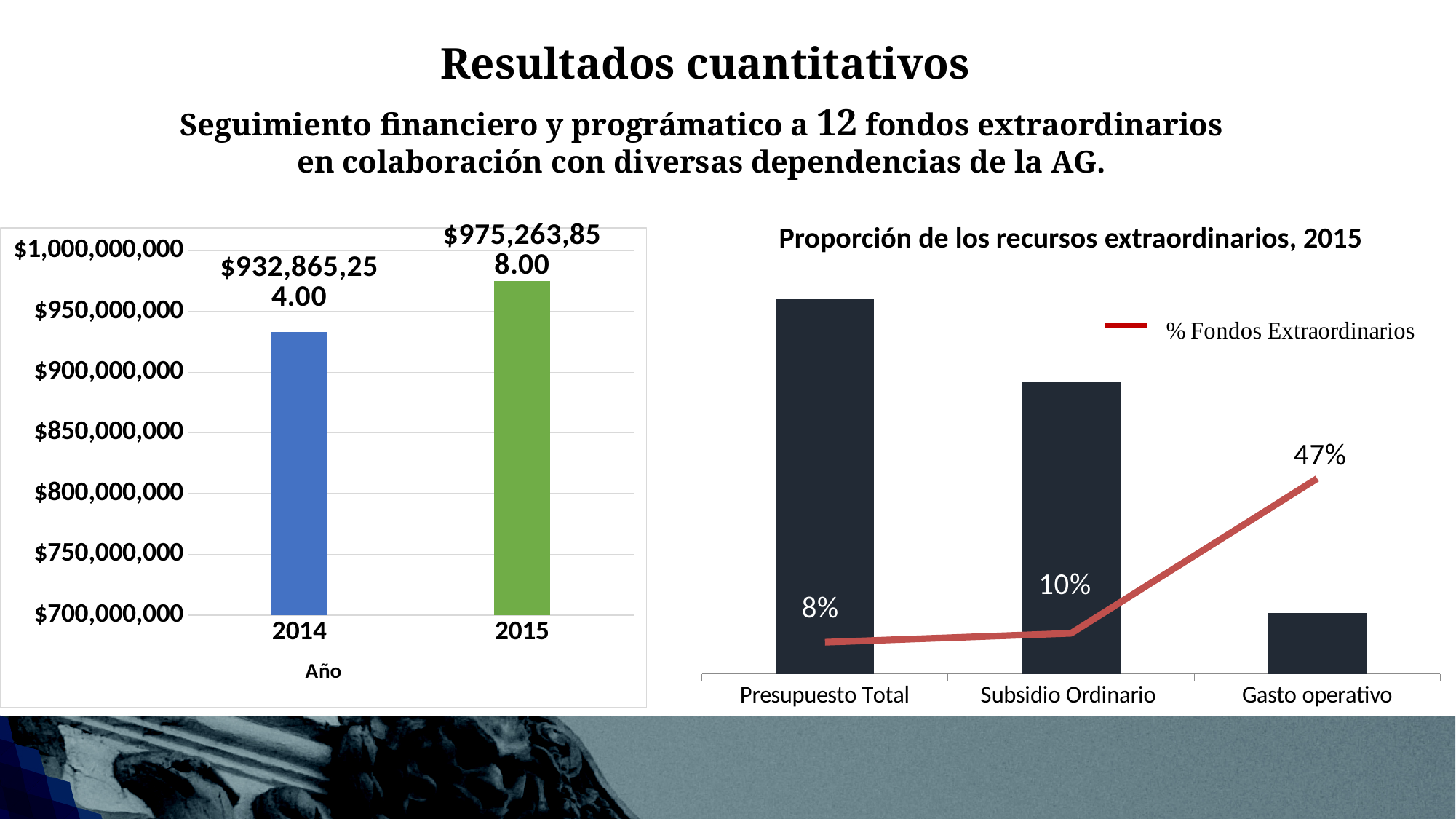
In the left bar chart, what is the x-axis title? Año In the chart 'Proporción de los recursos extraordinarios, 2015', does the % Fondos Extraordinarios line rise or fall from left to right? rise In the left bar chart, what is the difference between the 2015 and 2014 values? $42,398,604.00 In the chart 'Proporción de los recursos extraordinarios, 2015', what is the % Fondos Extraordinarios value for Presupuesto Total? 8% In the left bar chart, which year has the higher value? 2015 In the chart 'Proporción de los recursos extraordinarios, 2015', what is the difference in % Fondos Extraordinarios between Gasto operativo and Subsidio Ordinario? 37% In the chart 'Proporción de los recursos extraordinarios, 2015', which category has the highest % Fondos Extraordinarios? Gasto operativo In the left bar chart, what is the value for 2014? $932,865,254.00 In the left bar chart, how many years are shown? 2 In the left bar chart, is the value for 2014 greater or less than $950,000,000? less In the left bar chart, what is the value for 2015? $975,263,858.00 In the chart 'Proporción de los recursos extraordinarios, 2015', what is the % Fondos Extraordinarios value for Gasto operativo? 47%